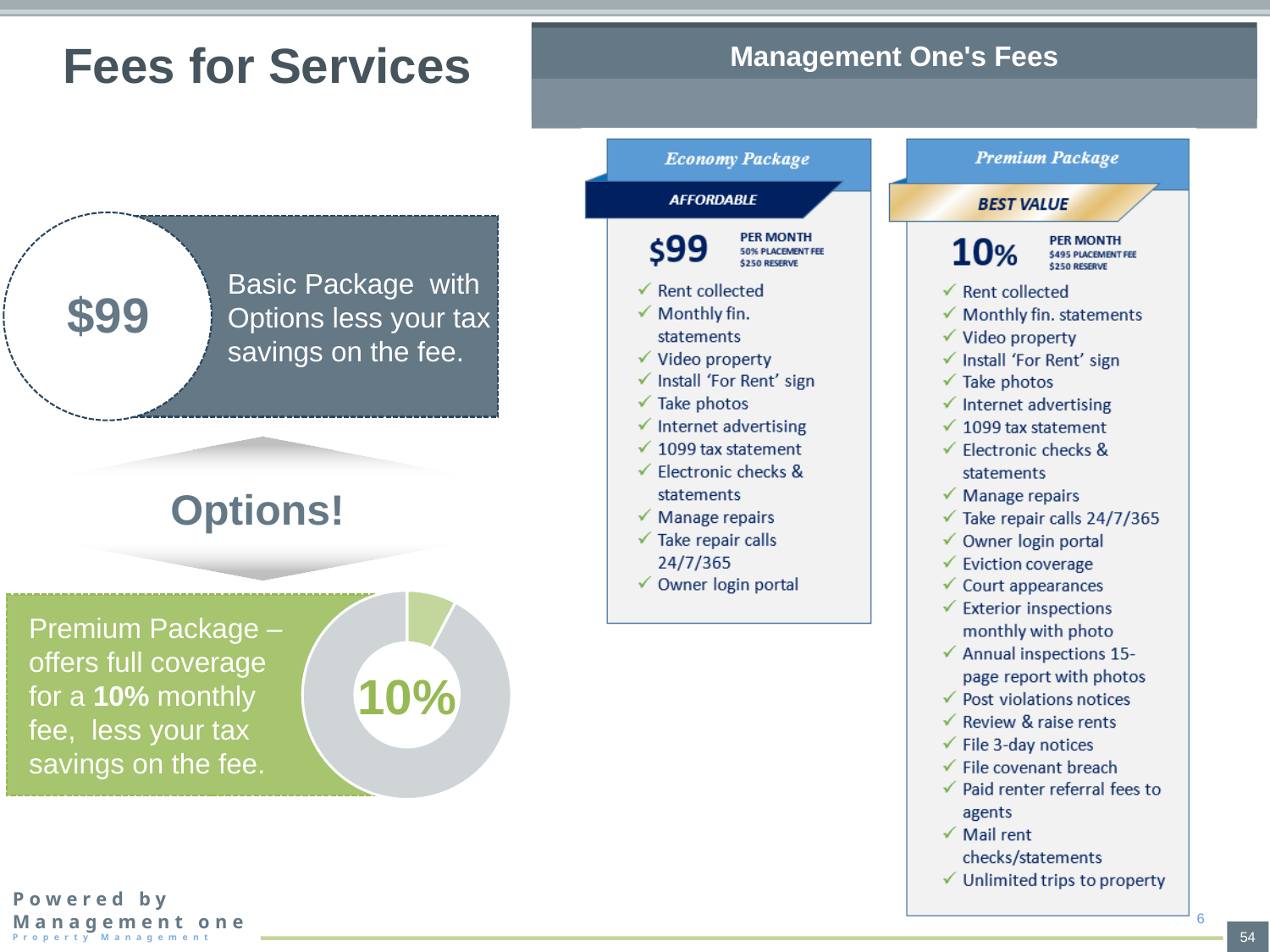
In the donut chart, is the green slice larger or smaller than the gray slice? smaller What percentage is printed in the centre of the donut chart on the slide? 10% How many slices does the donut chart on the slide have? 2 Which slice of the donut chart is the smallest? the green slice What kind of chart is shown in the lower-left of the slide next to the Premium Package text? pie chart (donut) What colour is the small slice of the donut chart? green Which package does the donut chart on the slide illustrate the monthly fee for? Premium Package Which slice of the donut chart is the largest? the gray slice